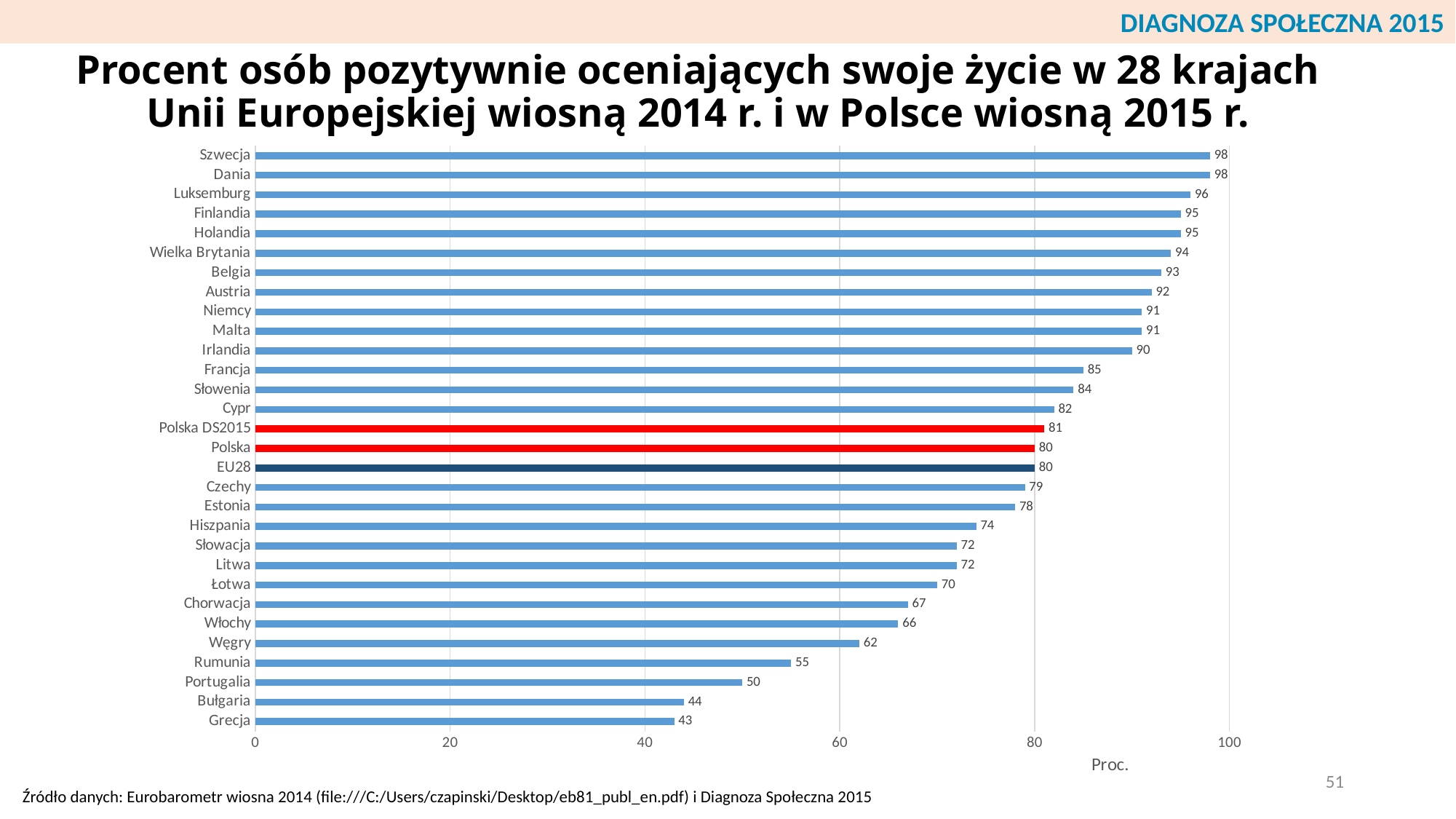
What is the difference between the values for Polska DS2015 and Polska? 1 What is the value for EU28? 80 What is the difference between the values for Szwecja and Grecja? 55 What kind of chart is shown on the slide? Bar chart How many bars are shown in the chart? 30 Which country has the lowest value? Grecja What is the value for Polska DS2015? 81 What is the value for Hiszpania? 74 Which has a larger value, Rumunia or Portugalia? Rumunia Which has a larger value, Czechy or Estonia? Czechy What is the value for Grecja? 43 What label is shown on the horizontal axis? Proc.